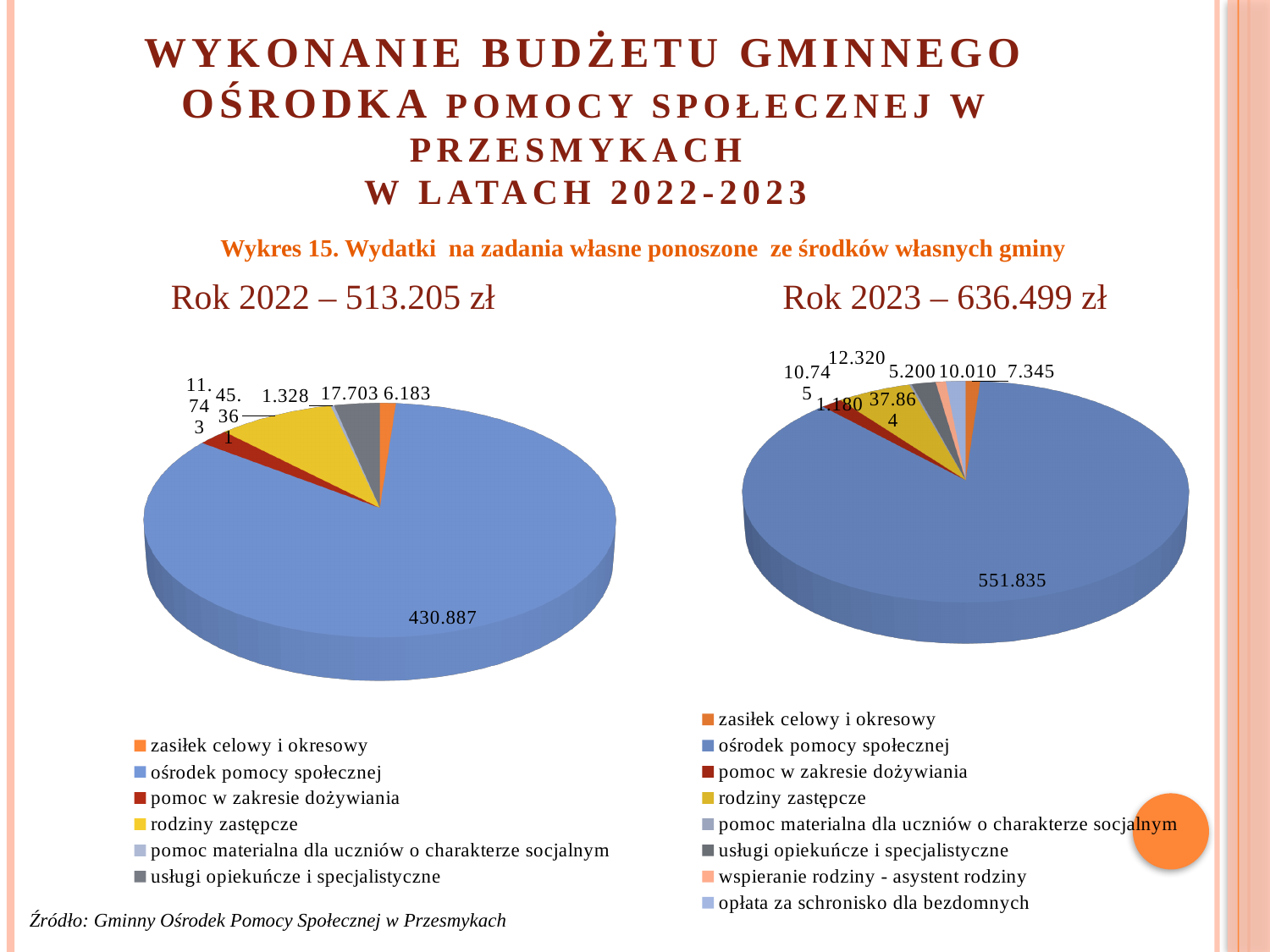
What type of chart is used on this slide for Rok 2022 and Rok 2023? Pie chart How many categories does the legend of the Rok 2023 pie chart list? 8 Which year shows a larger value for usługi opiekuńcze i specjalistyczne, Rok 2022 or Rok 2023? Rok 2022 What total amount is shown in the heading for Rok 2023? 636.499 zł How many categories does the legend of the Rok 2022 pie chart list? 6 In the Rok 2022 pie chart, which category has the largest slice? ośrodek pomocy społecznej In the Rok 2022 pie chart, what is the value for zasiłek celowy i okresowy? 6.183 In the Rok 2022 pie chart, what is the value for ośrodek pomocy społecznej? 430.887 In the Rok 2023 pie chart, what is the value for ośrodek pomocy społecznej? 551.835 In the Rok 2023 pie chart, what is the value for usługi opiekuńcze i specjalistyczne? 12.320 In the Rok 2023 pie chart, what is the value for opłata za schronisko dla bezdomnych? 10.010 In the Rok 2023 pie chart, what is the value for zasiłek celowy i okresowy? 7.345